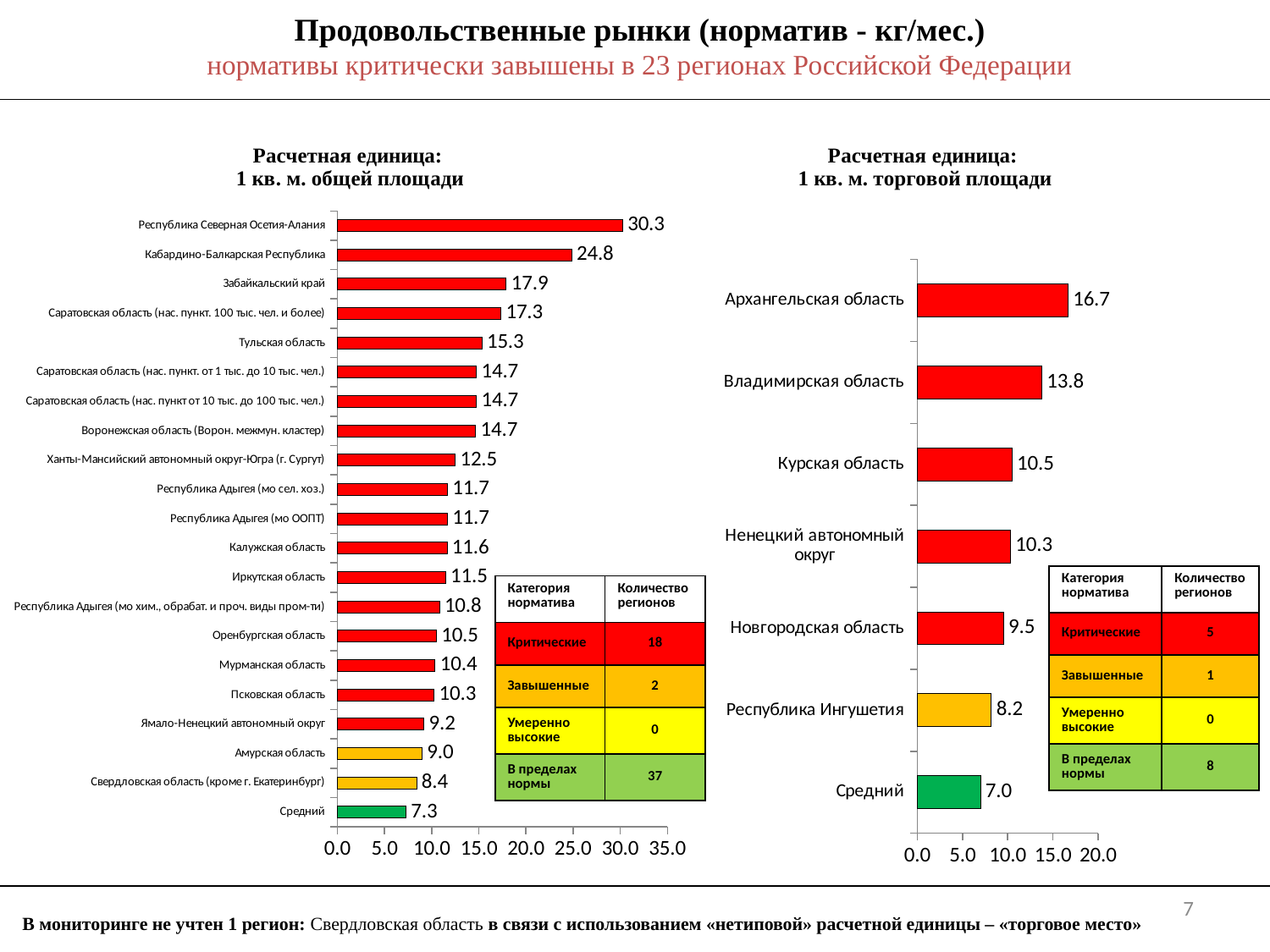
On the right chart (1 кв. м. торговой площади), what is the difference between Архангельская область and Средний? 9.7 On the left chart (1 кв. м. общей площади), which category has the lowest value? Средний On the right chart (1 кв. м. торговой площади), what is the value for Республика Ингушетия? 8.2 On the left chart (1 кв. м. общей площади), how many bars are plotted? 21 On the left chart (1 кв. м. общей площади), which category has the highest value? Республика Северная Осетия-Алания On the right chart (1 кв. м. торговой площади), what is the value for Архангельская область? 16.7 On the left chart (1 кв. м. общей площади), what is the value for Республика Северная Осетия-Алания? 30.3 What type of chart is used on the right side of the slide (1 кв. м. торговой площади)? Bar chart On the left chart (1 кв. м. общей площади), what is the difference between Республика Северная Осетия-Алания and Кабардино-Балкарская Республика? 5.5 On the right chart (1 кв. м. торговой площади), how many bars are plotted? 7 On the left chart (1 кв. м. общей площади), what is the value for Тульская область? 15.3 On the right chart (1 кв. м. торговой площади), which is larger: Владимирская область or Курская область? Владимирская область